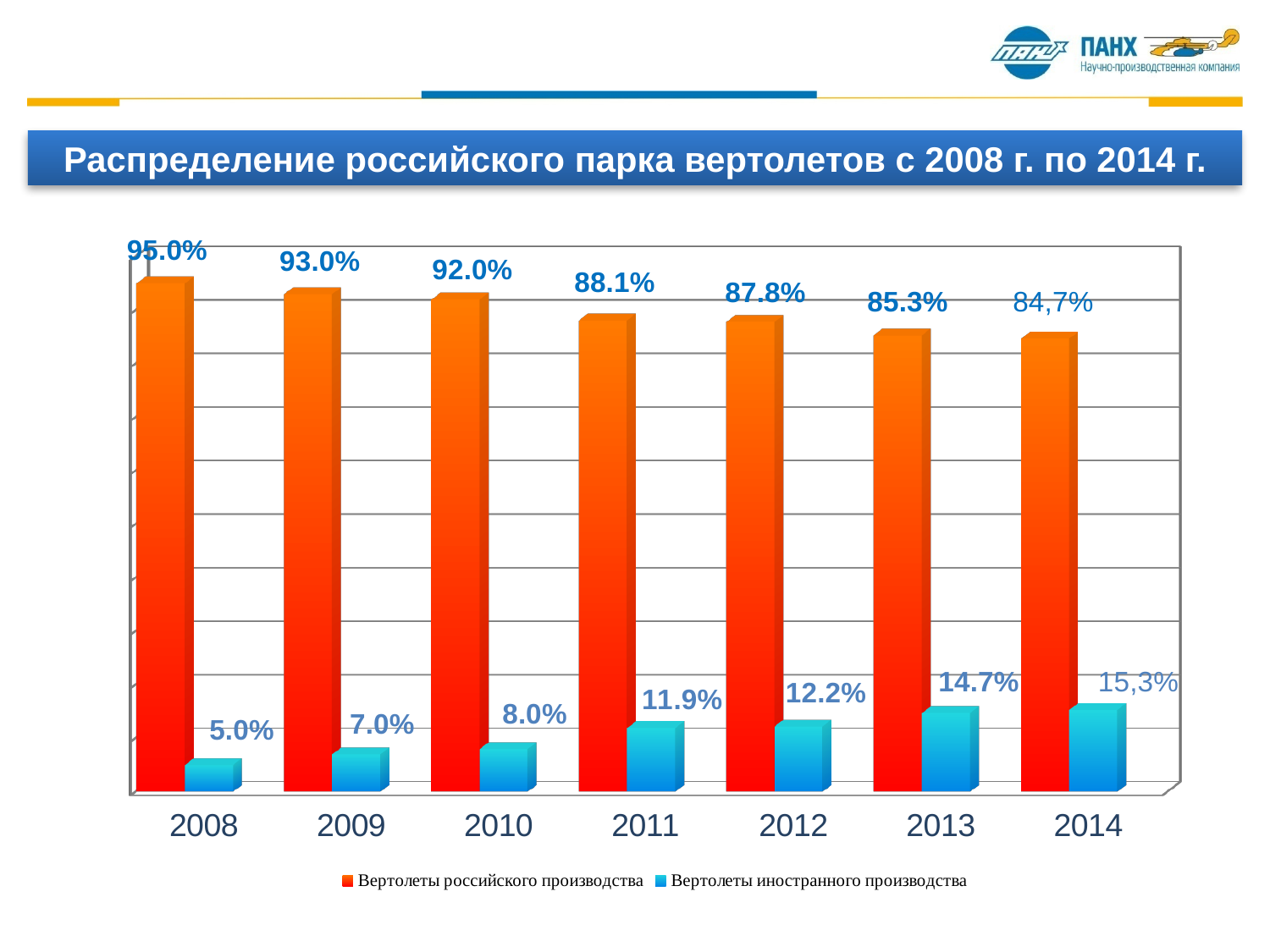
In which year is the share of Вертолеты российского производства lowest? 2014 Which is larger: the Вертолеты российского производства value in 2011 or in 2012? 2011 What is the difference between the Вертолеты иностранного производства values for 2010 and 2008? 3.0% What is the value for Вертолеты российского производства in 2008? 95.0% Do the values for Вертолеты российского производства rise or fall from 2008 to 2014? Fall What kind of chart is shown on the slide? Bar chart What is the value for Вертолеты иностранного производства in 2012? 12.2% In which year is the share of Вертолеты иностранного производства highest? 2014 What is the value for Вертолеты российского производства in 2014? 84,7% How many series does the legend list? 2 What is the value for Вертолеты иностранного производства in 2011? 11.9% How many years are shown on the x axis? 7